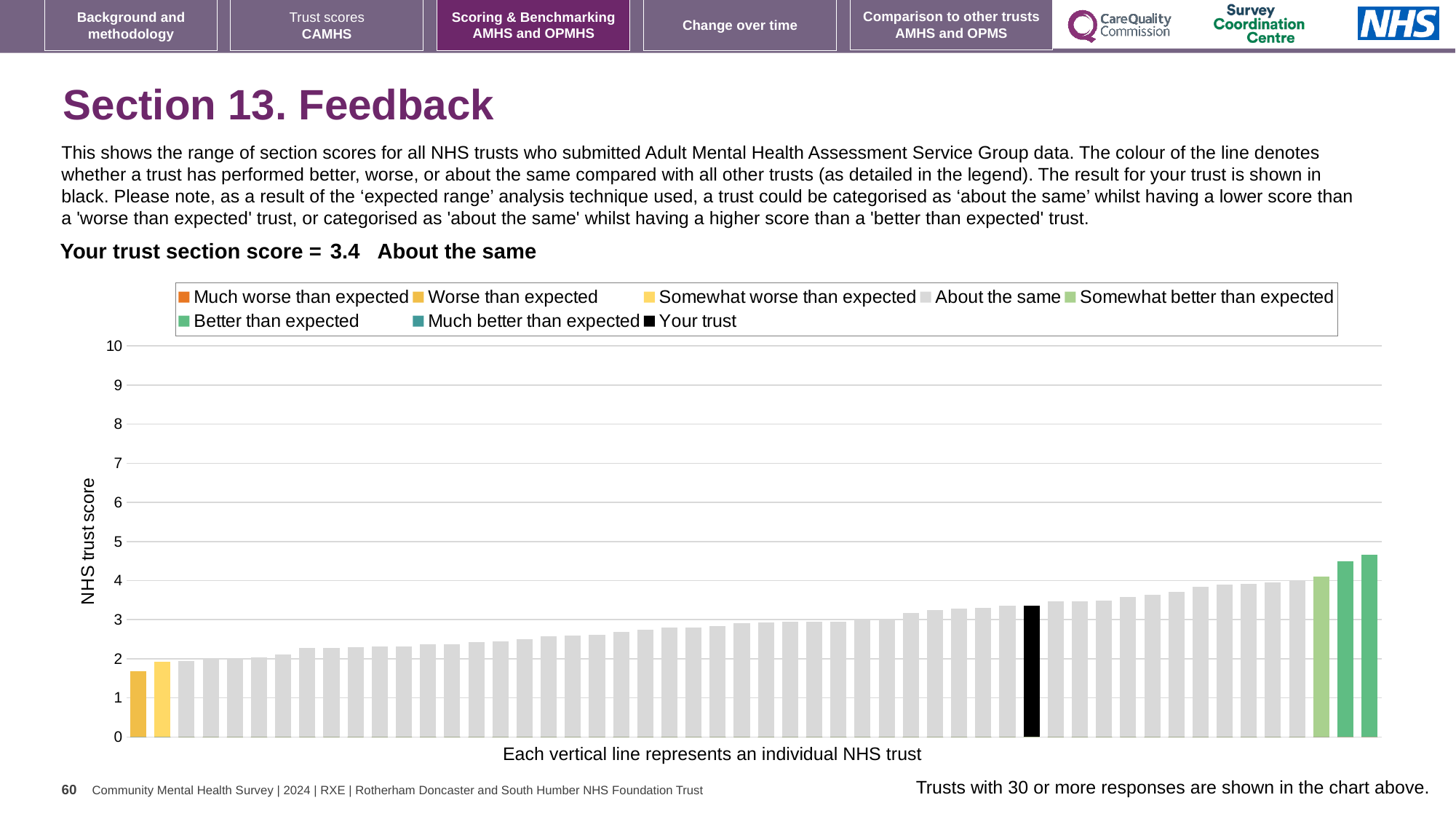
What kind of chart is shown on the slide? bar chart How many bars are coloured as 'Somewhat better than expected' (light green)? 1 Is the value of the tallest bar in the chart greater or less than 4? greater Which category is your trust's section score placed in? About the same How many bars are coloured as 'Better than expected' (dark green)? 2 Is the value of the black 'Your trust' bar greater or less than 3? greater What colour is the bar representing your trust? black How many entries does the chart legend list? 8 Is the value of the shortest bar in the chart greater or less than 2? less Do the bar values rise or fall from left to right along the x axis? rise What is the title of the y axis? NHS trust score What is the section score for your trust shown on the slide? 3.4